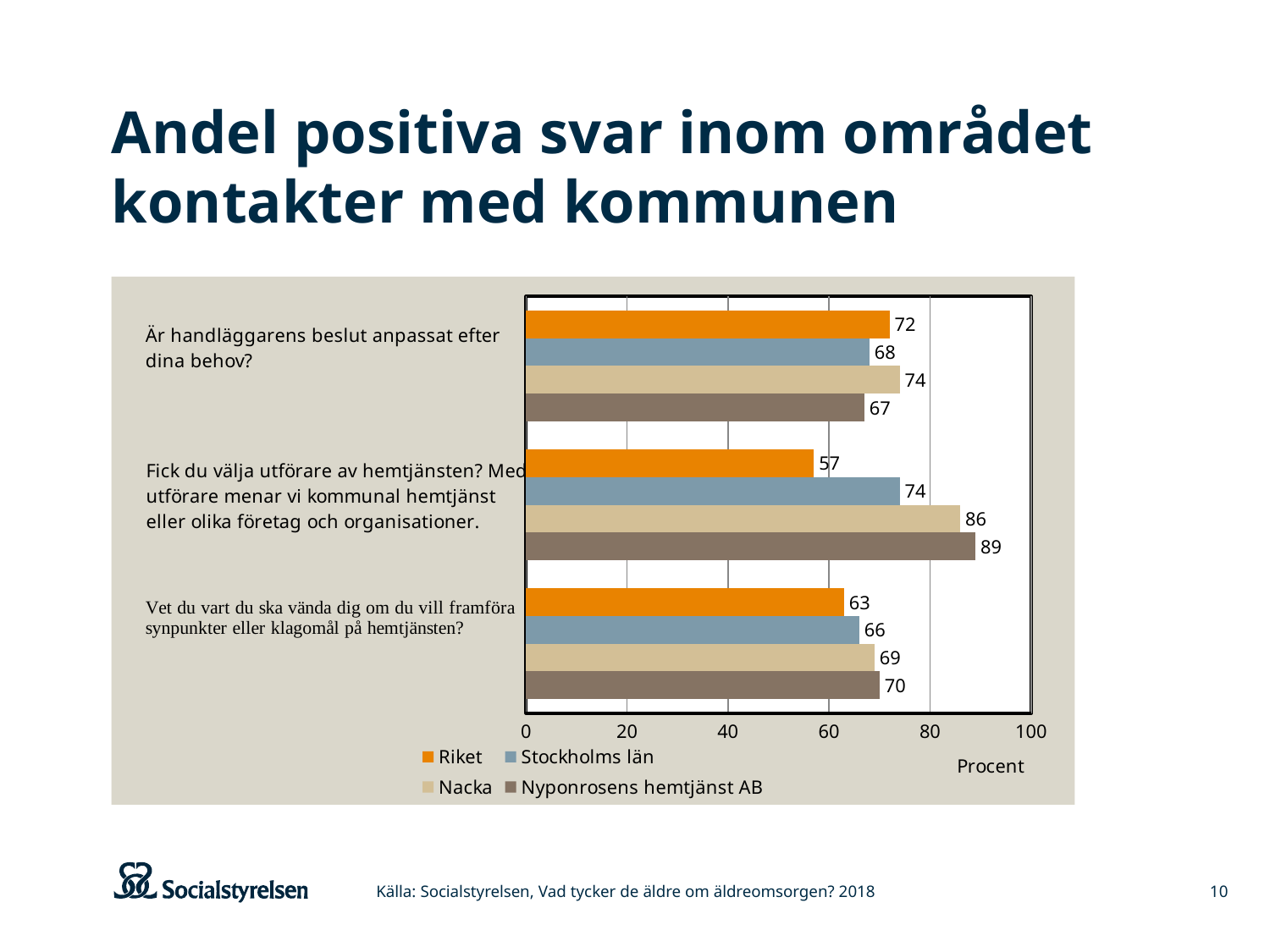
Which series has the lowest value on the question "Är handläggarens beslut anpassat efter dina behov?"? Nyponrosens hemtjänst AB What is the value for Stockholms län on the question "Vet du vart du ska vända dig om du vill framföra synpunkter eller klagomål på hemtjänsten?"? 66 Which series has the highest value on the question "Fick du välja utförare av hemtjänsten?"? Nyponrosens hemtjänst AB Which is larger on the question "Är handläggarens beslut anpassat efter dina behov?": the value for Nacka or the value for Stockholms län? Nacka What is the value for Riket on the question "Är handläggarens beslut anpassat efter dina behov?"? 72 How many questions (categories) are shown in the chart? 3 What is the value for Nyponrosens hemtjänst AB on the question "Fick du välja utförare av hemtjänsten?"? 89 Is the value for Riket on the question "Fick du välja utförare av hemtjänsten?" greater or less than 60? less What kind of chart is shown on the slide? bar chart How many series does the legend list? 4 What is the difference between the Nacka and Riket values on the question "Fick du välja utförare av hemtjänsten?"? 29 What unit is shown on the horizontal axis of the chart? Procent